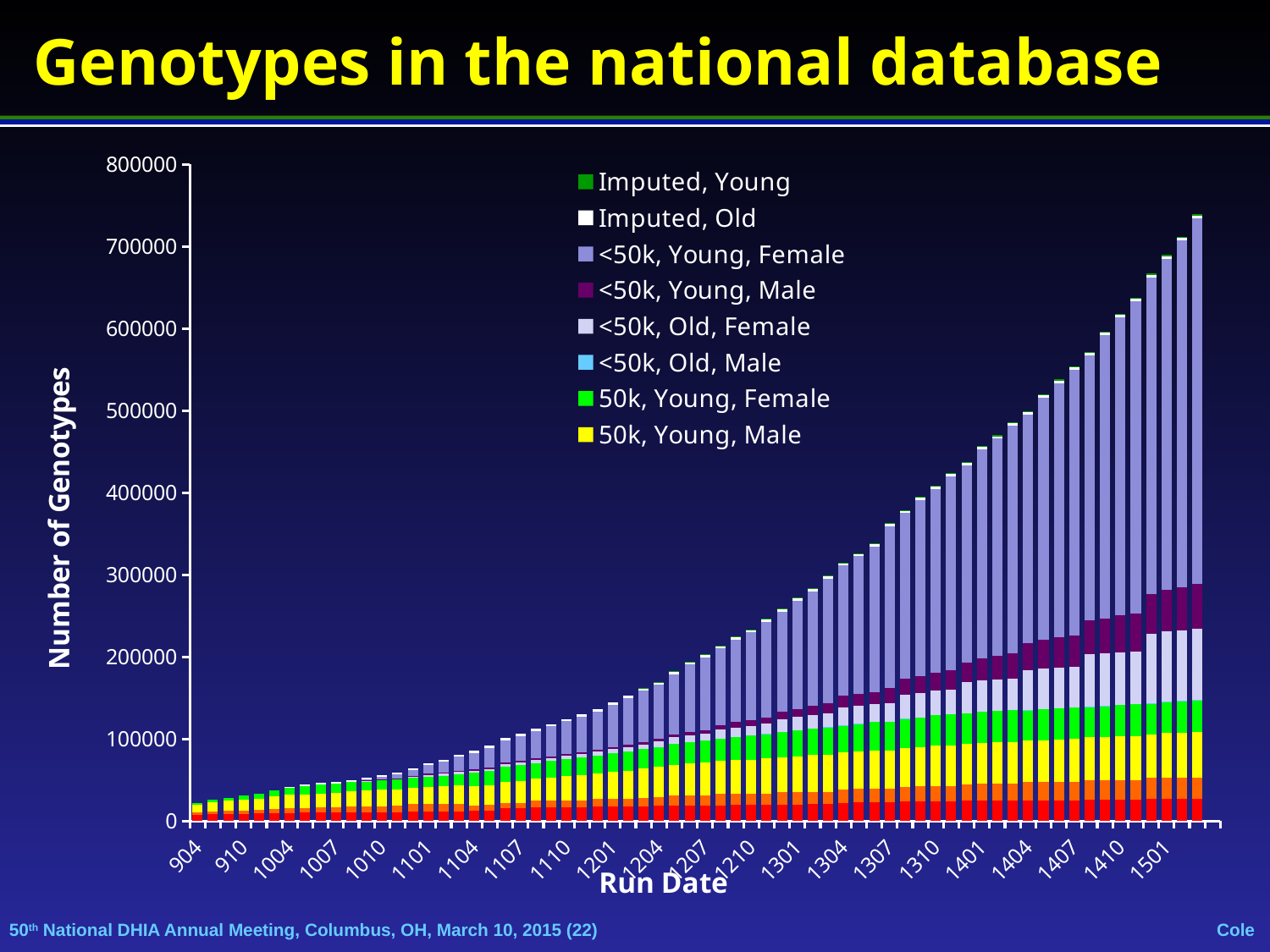
Do the total number of genotypes rise or fall along the x axis from 904 to 1501? rise What is the title of the chart? Genotypes in the national database Is the total value for run date 1301 greater or less than 200000? greater What is the label of the y axis? Number of Genotypes Which total is larger, the bar at run date 1204 or the bar at run date 1404? 1404 Is the total value for run date 1501 greater or less than 600000? greater How many series does the chart legend list? 8 Is the total value for run date 904 greater or less than 100000? less Which run date has the lowest total number of genotypes? 904 What kind of chart is shown on the slide? stacked bar chart